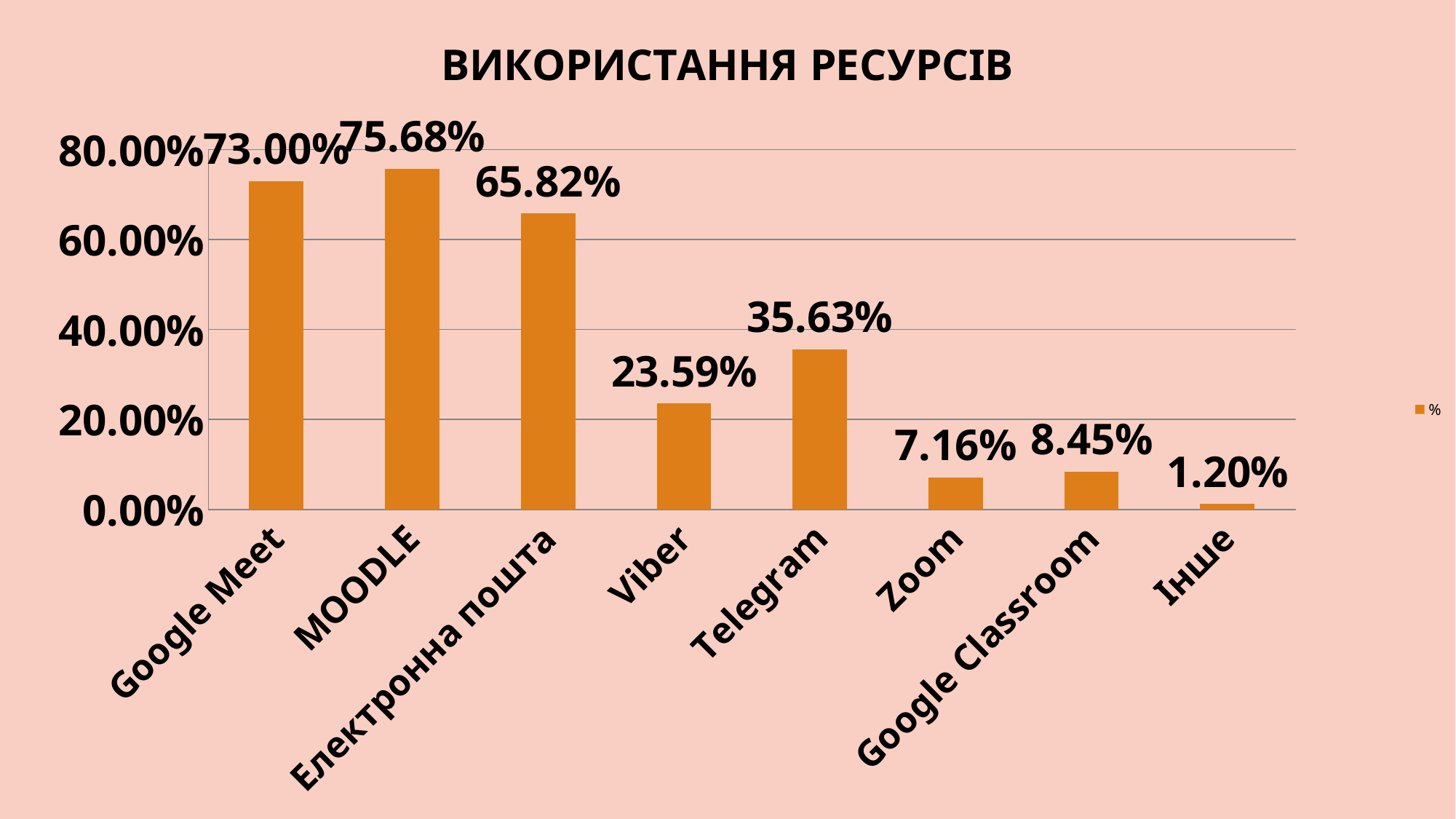
What is the title of the chart? ВИКОРИСТАННЯ РЕСУРСІВ What is the value for MOODLE? 75.68% How many series does the legend list? 1 Which category has the lowest value? Інше Which is larger, the value for Zoom or the value for Google Classroom? Google Classroom Is the value for Електронна пошта greater or less than 60.00%? greater How many categories are shown on the x axis? 8 Which category has the highest value? MOODLE What is the difference between the values for Google Meet and Viber? 49.41% What kind of chart is shown? bar chart What is the value for Telegram? 35.63% What is the value for Google Classroom? 8.45%